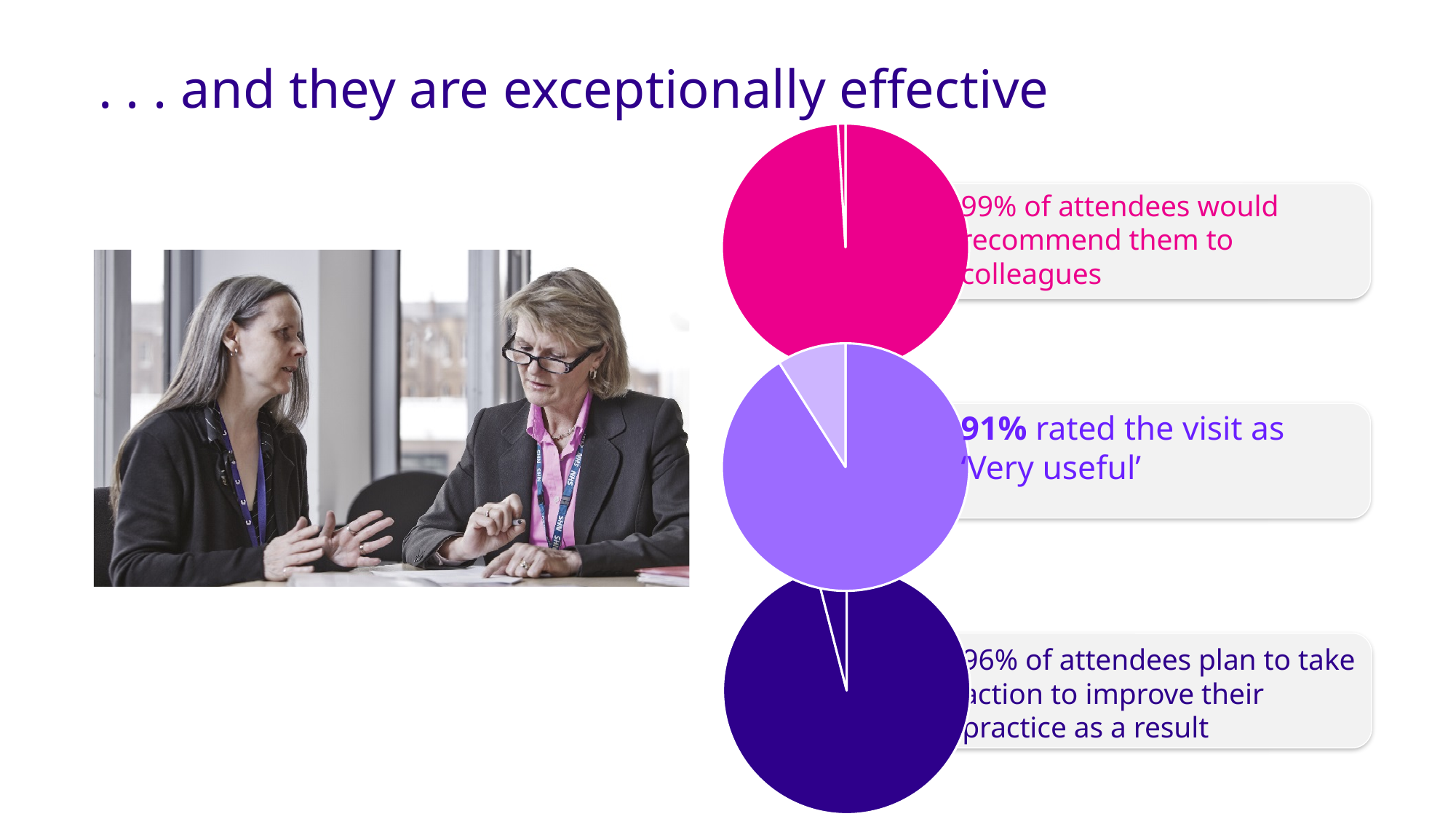
In the bottom pie chart, what share of attendees plan to take action to improve their practice as a result? 96% How many pie charts are shown on the slide? 3 What is the difference in percentage points between the share who would recommend the visits (99%) and the share who rated the visit as 'Very useful' (91%)? 8 percentage points In the middle pie chart, what share of attendees rated the visit as 'Very useful'? 91% In the top pie chart, what share of attendees would recommend the visits to colleagues? 99% Is the share of attendees who rated the visit as 'Very useful' greater or less than the share who plan to take action to improve their practice? less What is the title of the slide containing the three pie charts? . . . and they are exceptionally effective Which of the three pie charts has the largest minority slice? The middle pie chart (91% rated the visit as 'Very useful') What colour is the pie chart for the 99% of attendees who would recommend the visits to colleagues? Pink Which of the three pie charts has the smallest minority slice? The top pie chart (99% would recommend them to colleagues) What kind of chart is used to show the 99% of attendees who would recommend the visits to colleagues? Pie chart What is the difference in percentage points between the share who plan to take action (96%) and the share who rated the visit as 'Very useful' (91%)? 5 percentage points